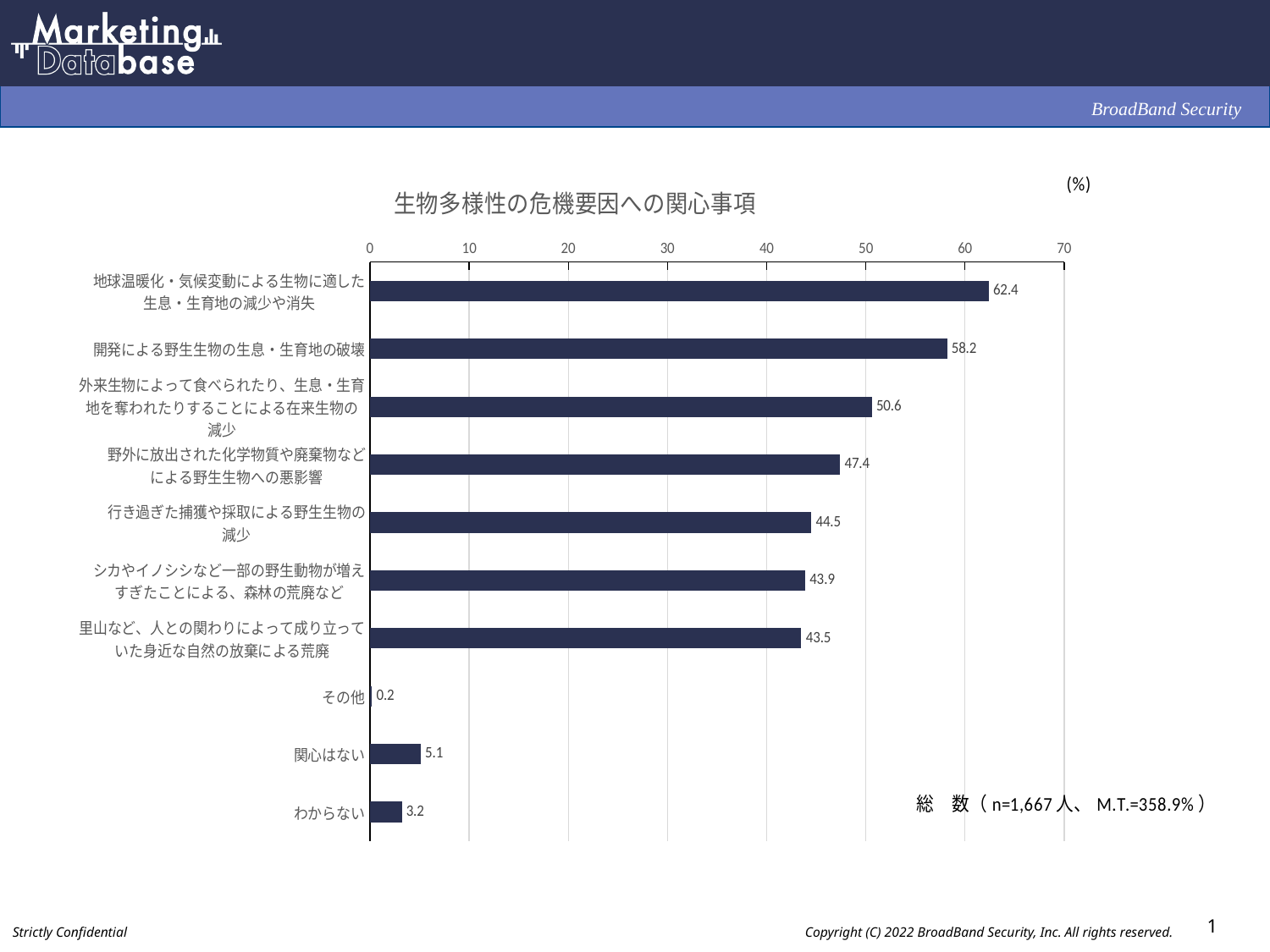
What is the value for 開発による野生生物の生息・生育地の破壊? 58.2 Which category has the highest value? 地球温暖化・気候変動による生物に適した生息・生育地の減少や消失 What kind of chart is shown on the slide? bar chart What is the difference between the values for 地球温暖化・気候変動による生物に適した生息・生育地の減少や消失 and 開発による野生生物の生息・生育地の破壊? 4.2 What is the value for 関心はない? 5.1 What is the sample size (n) shown on the slide? n=1,667人 What is the value for 行き過ぎた捕獲や採取による野生生物の減少? 44.5 Is the value for 外来生物によって食べられたり、生息・生育地を奪われたりすることによる在来生物の減少 greater or less than 50? greater Which category has the lowest value? その他 How many categories are shown in the chart? 10 Which is larger: the value for 関心はない or the value for わからない? 関心はない What is the title of the chart? 生物多様性の危機要因への関心事項